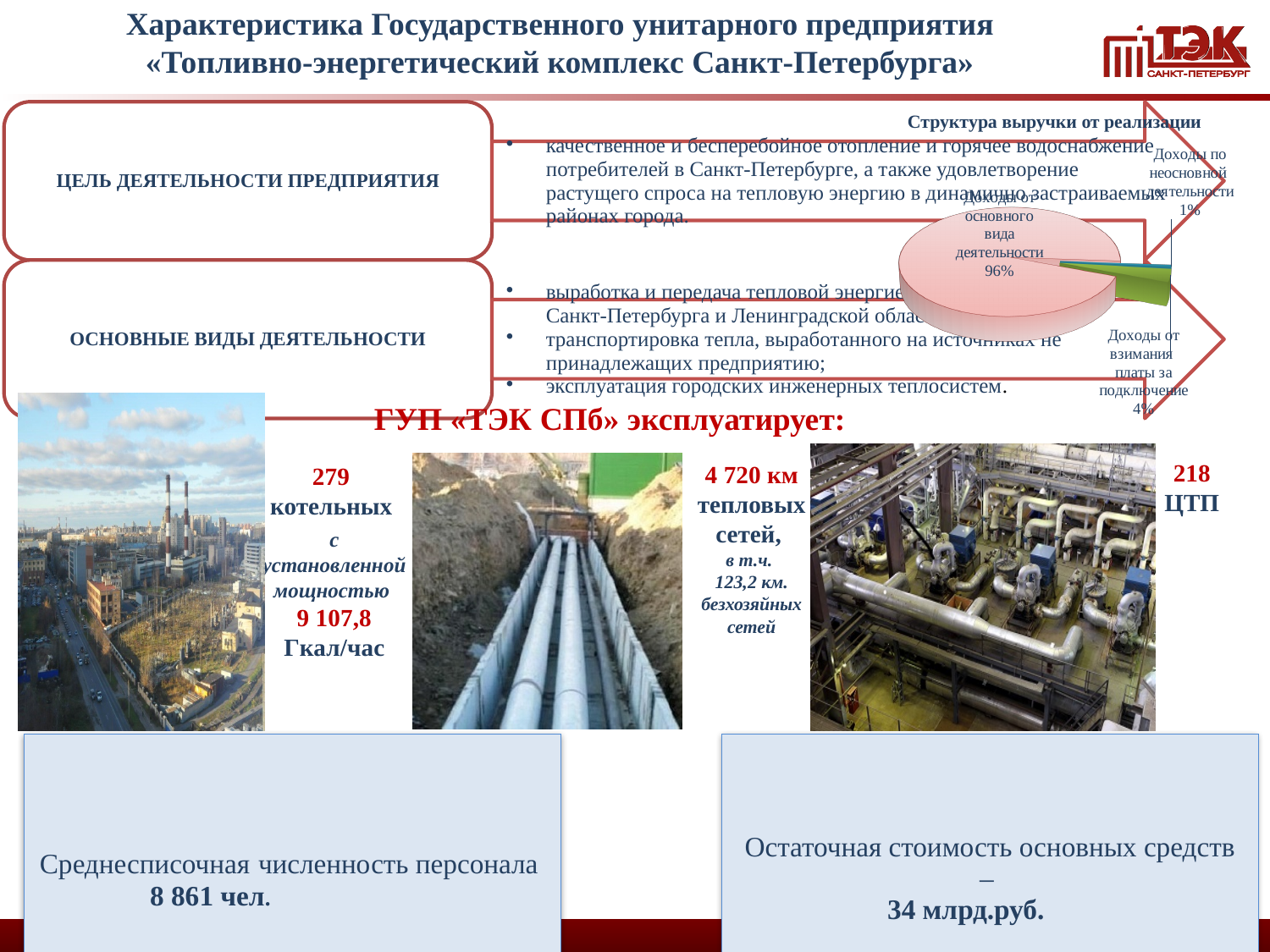
In the pie chart "Структура выручки от реализации", which category has the largest share? Доходы от основного вида деятельности In the pie chart "Структура выручки от реализации", what is the difference in percentage points between the share for "Доходы от основного вида деятельности" and the share for "Доходы от взимания платы за подключение"? 92 In the pie chart "Структура выручки от реализации", what colour is the largest slice? pink In the pie chart "Структура выручки от реализации", what share is labelled for "Доходы по неосновной деятельности"? 1% In the pie chart "Структура выручки от реализации", what is the difference in percentage points between the share for "Доходы от взимания платы за подключение" and the share for "Доходы по неосновной деятельности"? 3 In the pie chart "Структура выручки от реализации", which category has the smallest share? Доходы по неосновной деятельности In the pie chart "Структура выручки от реализации", how many slices are shown? 3 In the pie chart "Структура выручки от реализации", which is larger: the share for "Доходы от взимания платы за подключение" or for "Доходы по неосновной деятельности"? Доходы от взимания платы за подключение What is the title of the pie chart on the slide? Структура выручки от реализации What type of chart is shown under the title "Структура выручки от реализации"? pie chart In the pie chart "Структура выручки от реализации", what share is labelled for "Доходы от основного вида деятельности"? 96% In the pie chart "Структура выручки от реализации", what share is labelled for "Доходы от взимания платы за подключение"? 4%